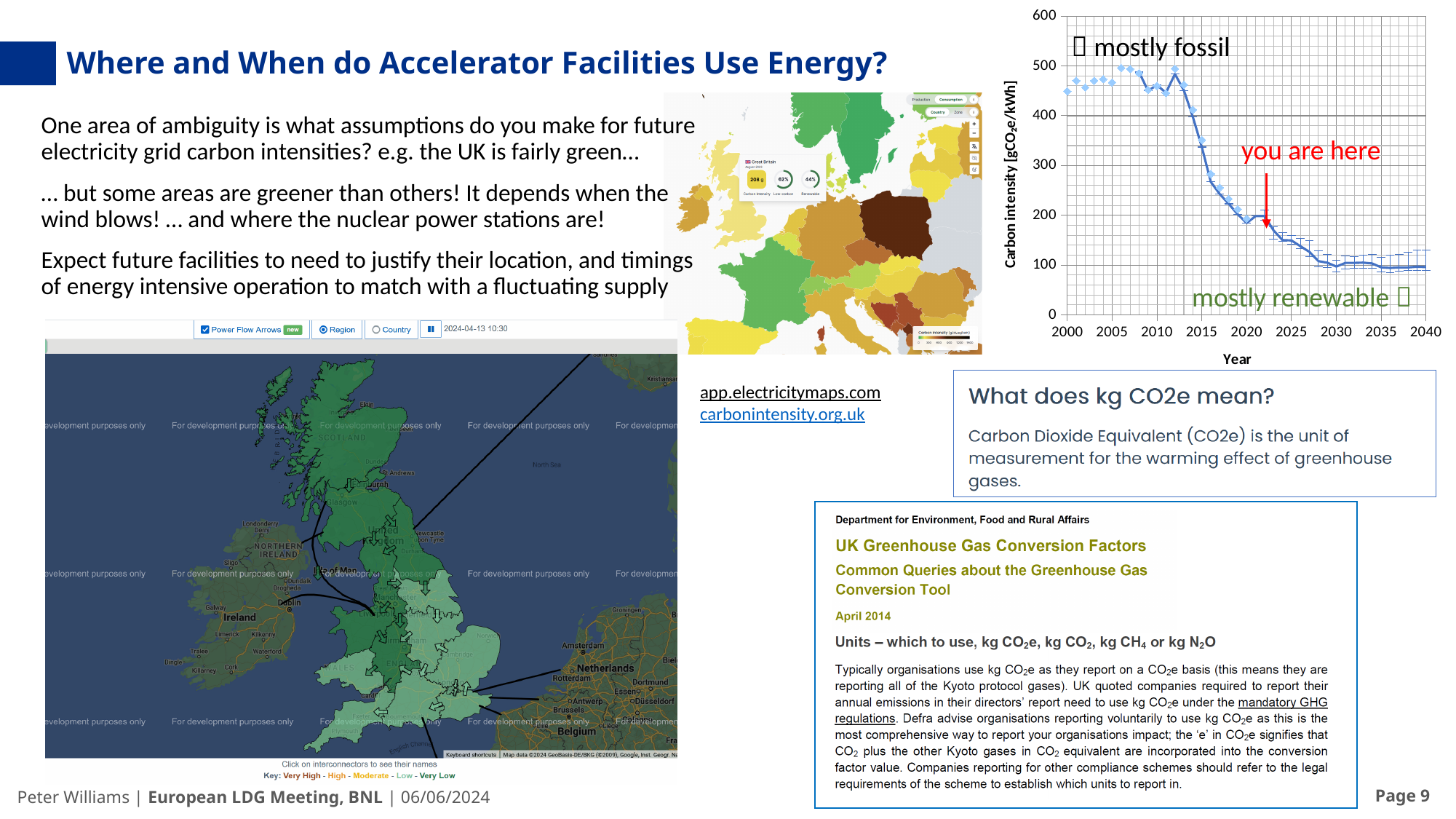
In the carbon intensity chart, is the value for 2040 greater or less than 200? less In the carbon intensity chart, is the value for 2010 greater or less than 300? greater In the carbon intensity chart, which is larger, the value for 2005 or the value for 2030? 2005 What kind of chart is the carbon intensity chart in the top right of the slide? line chart In the carbon intensity chart, is the value for 2035 greater or less than 200? less What is the label on the y axis of the carbon intensity chart? Carbon intensity [gCO2e/kWh] What red annotation is written on the carbon intensity chart near 2022? you are here In the carbon intensity chart, do the values generally rise or fall from 2000 to 2040? fall